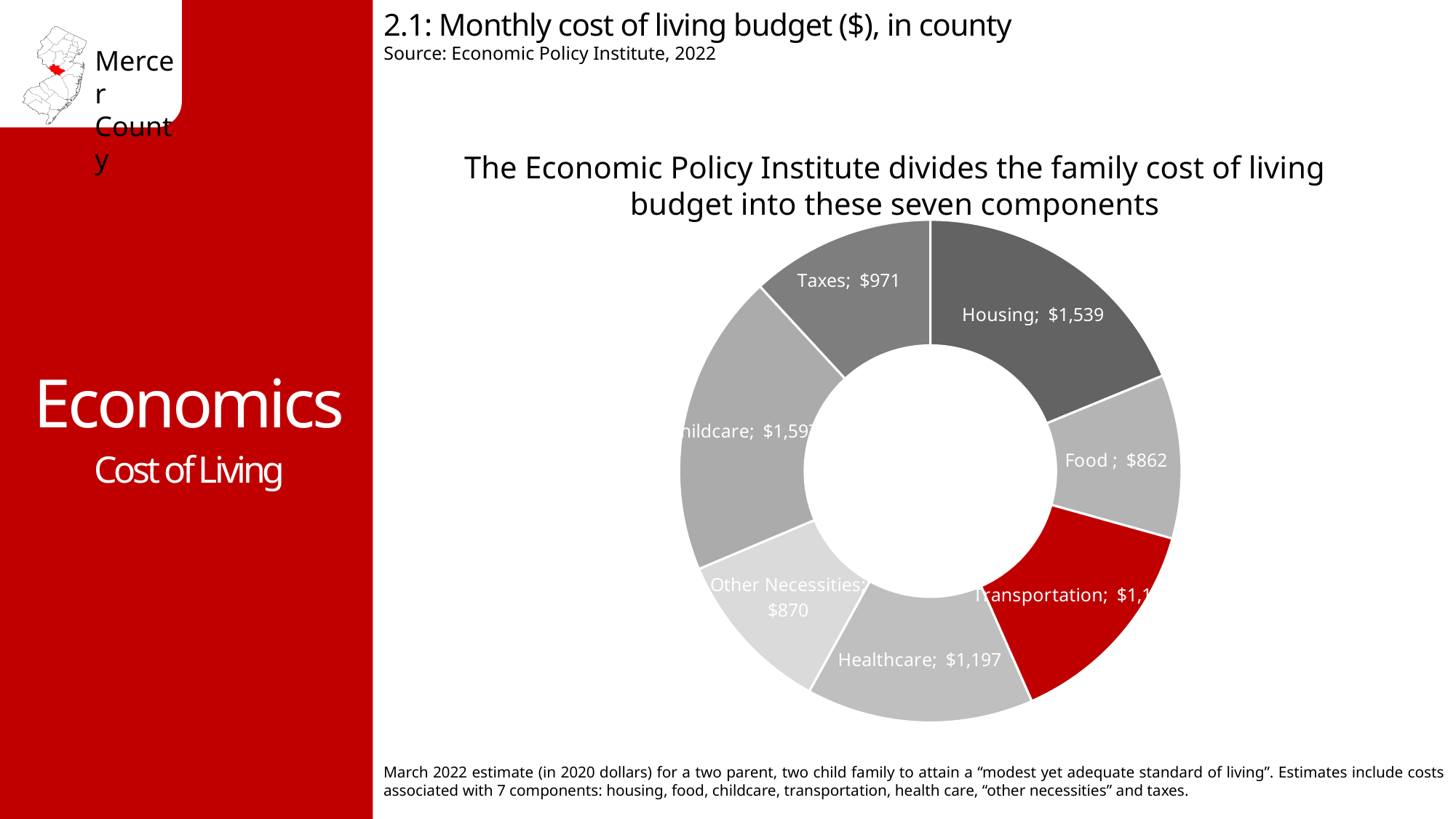
Which is larger, the Housing cost or the Healthcare cost? Housing What is the monthly cost for Food in the chart? $862 What is the monthly cost for Housing in the chart? $1,539 What kind of chart is shown on the slide? Doughnut (pie) chart How much more is the Housing cost than the Taxes cost? $568 What is the monthly cost for Taxes in the chart? $971 Which component is shown in red in the chart? Transportation Which is larger, the Taxes cost or the Food cost? Taxes What is the difference between the Healthcare cost and the Food cost? $335 How many components (slices) does the chart show? 7 What is the monthly cost for Other Necessities in the chart? $870 What is the monthly cost for Healthcare in the chart? $1,197